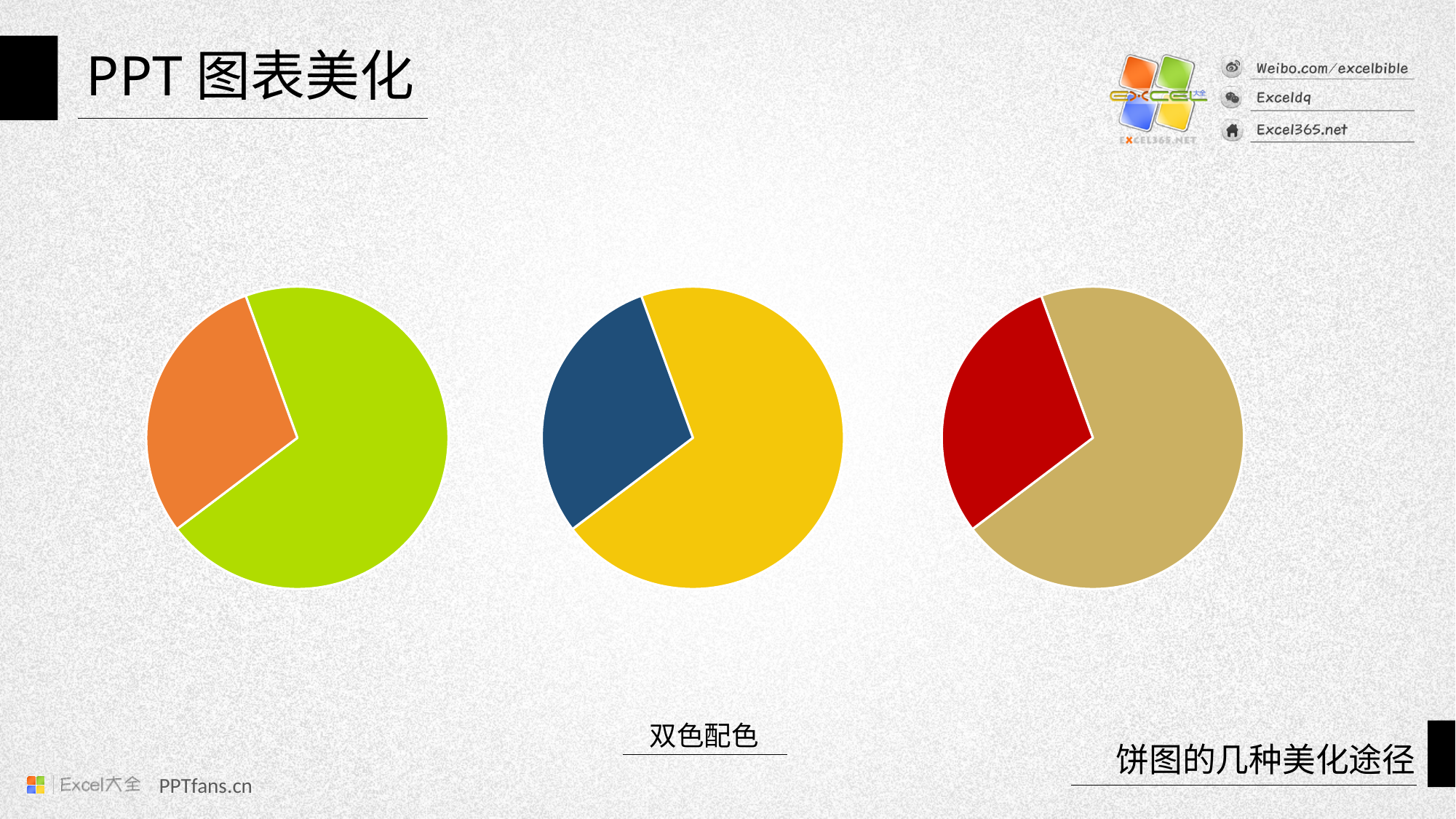
What two colours are used in the middle pie chart? yellow and dark blue What kind of chart is the left chart on the slide? pie chart In the right pie chart, which slice is larger, the tan one or the red one? the tan one In the middle pie chart, which slice is larger, the yellow one or the blue one? the yellow one How many slices does the left pie chart have? 2 How many slices does the middle pie chart have? 2 What kind of chart is the right chart on the slide? pie chart How many slices does the right pie chart have? 2 What kind of chart is the middle chart on the slide? pie chart In the left pie chart, which slice is larger, the green one or the orange one? the green one What is the caption printed below the pie charts? 双色配色